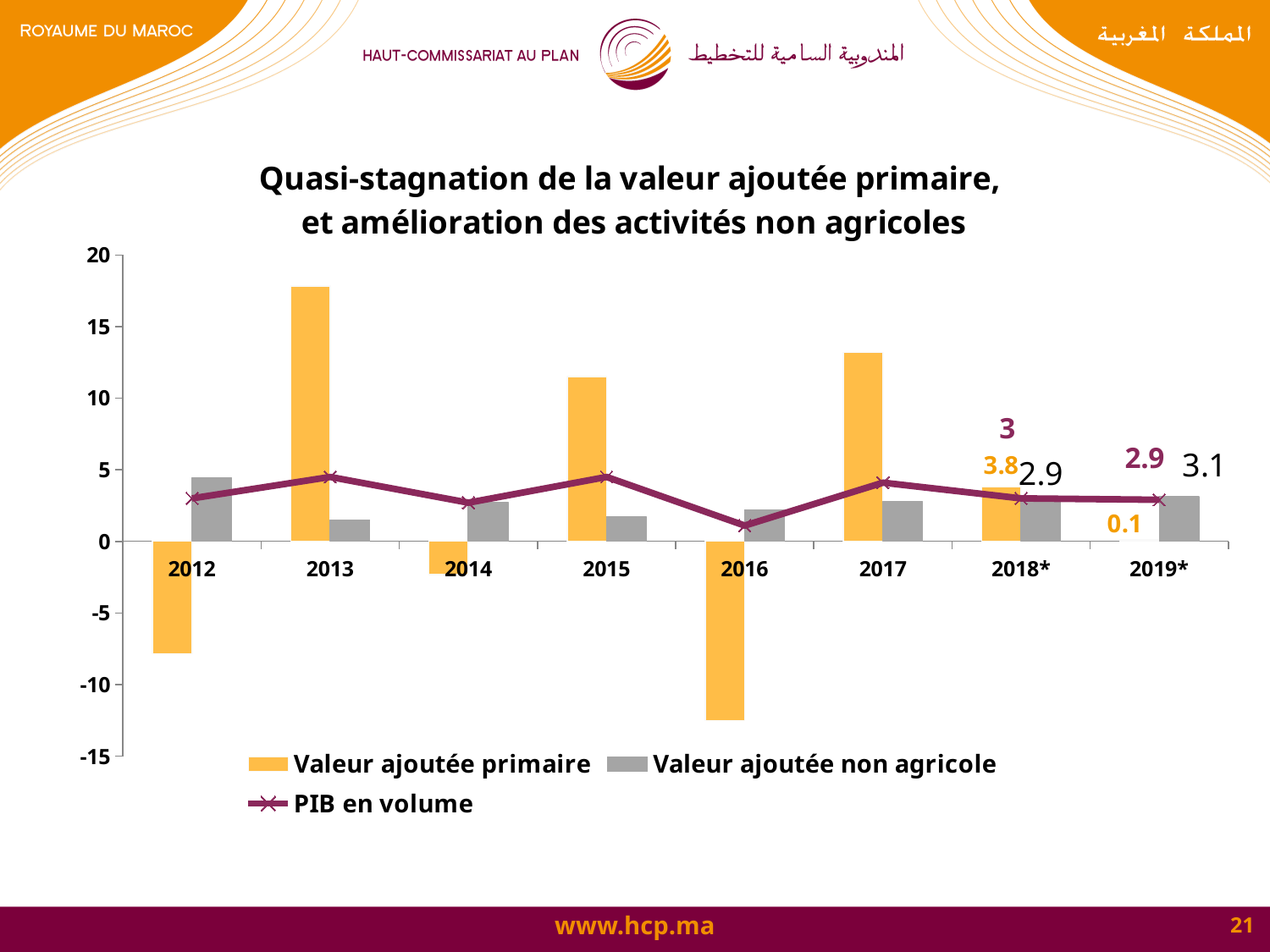
What is the value of PIB en volume for 2019*? 2.9 What is the value of PIB en volume for 2018*? 3 In 2018*, which is larger: Valeur ajoutée primaire or Valeur ajoutée non agricole? Valeur ajoutée primaire What is the value of Valeur ajoutée primaire for 2019*? 0.1 What is the difference between Valeur ajoutée primaire in 2018* and in 2019*? 3.7 In which year is the Valeur ajoutée primaire bar the lowest? 2016 In which year is the Valeur ajoutée primaire bar the highest? 2013 What is the value of Valeur ajoutée primaire for 2018*? 3.8 How many series does the legend list? 3 What is the value of Valeur ajoutée non agricole for 2019*? 3.1 How many years are shown on the x axis? 8 Is the value for Valeur ajoutée primaire in 2013 greater or less than 15? greater